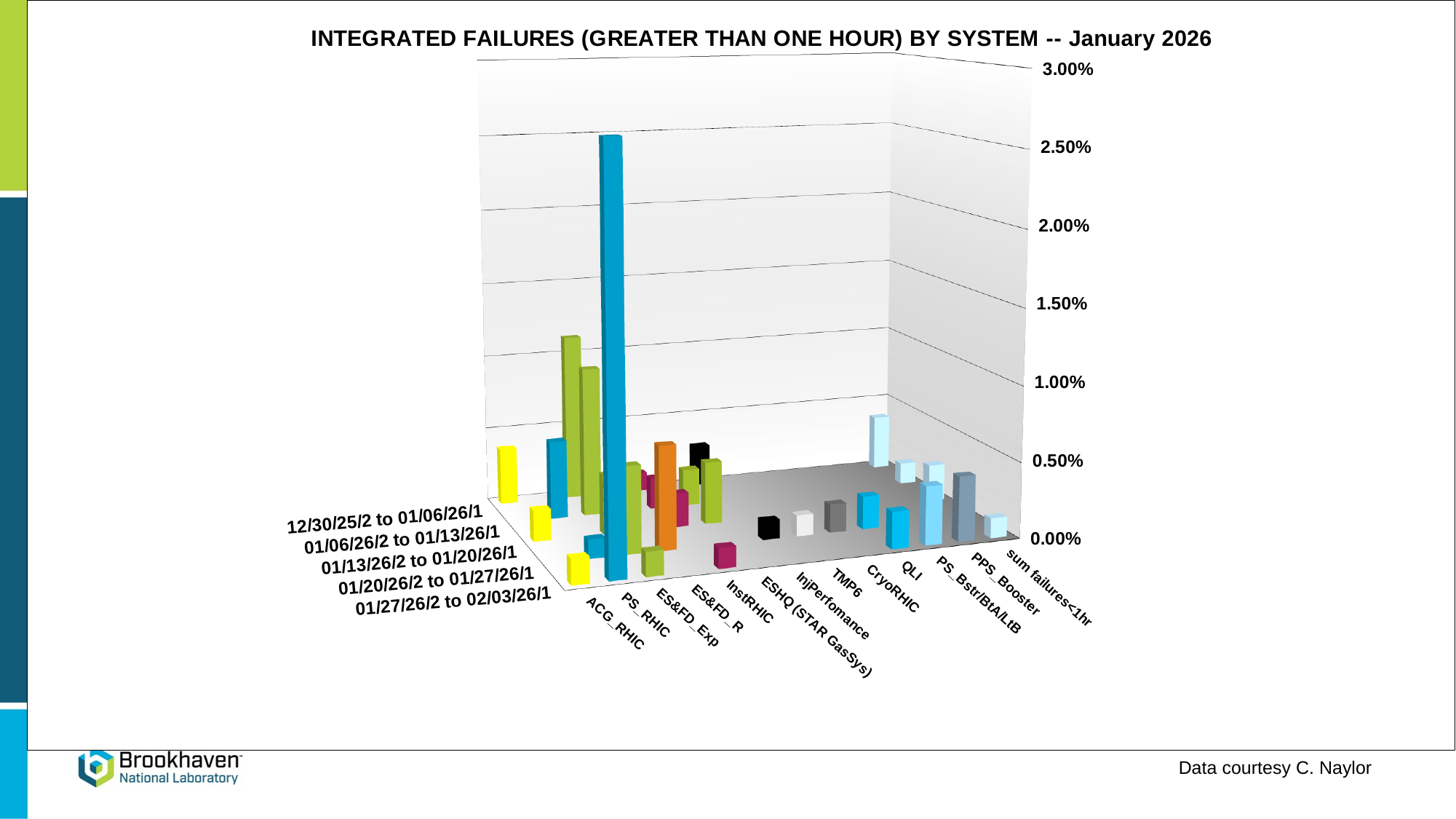
What is the title of the chart? INTEGRATED FAILURES (GREATER THAN ONE HOUR) BY SYSTEM -- January 2026 Which is the first date range listed on the depth axis? 12/30/25/2 to 01/06/26/1 What kind of chart is shown on the slide? bar chart Is the tallest bar for PS_RHIC greater or less than 2.00%? greater Is the tallest bar for ES&FD_Exp greater or less than 1.50%? less How many systems are listed along the horizontal axis of the chart? 13 Which system has a taller maximum bar, PS_RHIC or TMP6? PS_RHIC Is the tallest bar for ACG_RHIC greater or less than 1.00%? less What is the highest value shown on the vertical axis? 3.00% How many weekly date ranges are listed along the depth axis of the chart? 5 Which system has the tallest bar in the chart? PS_RHIC Which is the last system listed on the horizontal axis? sum failures<1hr